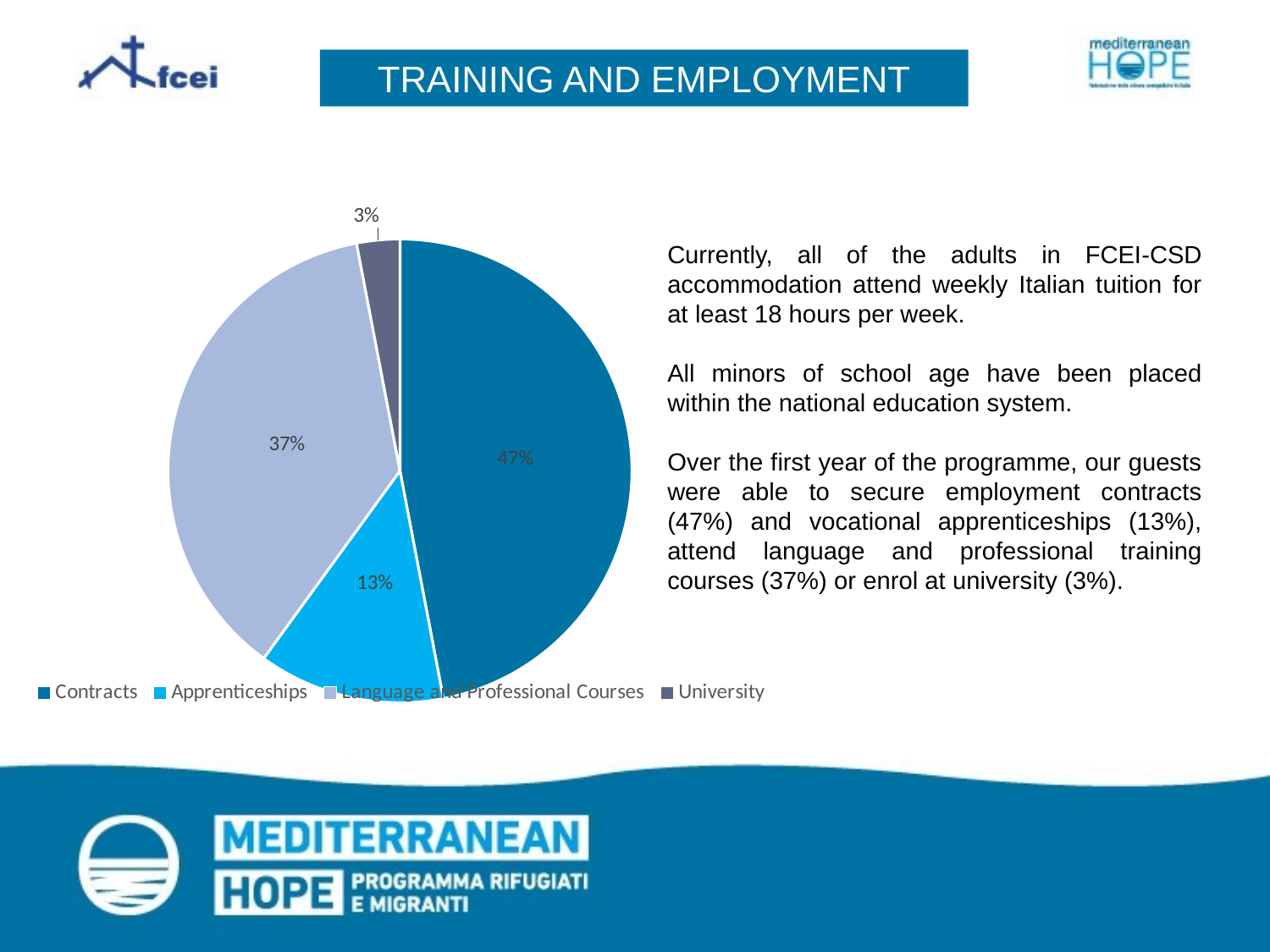
What kind of chart is shown on the slide? pie chart Which category has the largest slice of the pie chart? Contracts What is the difference in percentage points between Contracts and Language and Professional Courses? 10 Which category has the smallest slice of the pie chart? University What share of the pie chart is Language and Professional Courses? 37% What share of the pie chart is Contracts? 47% What colour is the Apprenticeships slice in the pie chart? light blue How many categories does the pie chart show? 4 What is the combined share of Contracts and Apprenticeships? 60% Which is larger, Apprenticeships or Language and Professional Courses? Language and Professional Courses What share of the pie chart is University? 3% What share of the pie chart is Apprenticeships? 13%